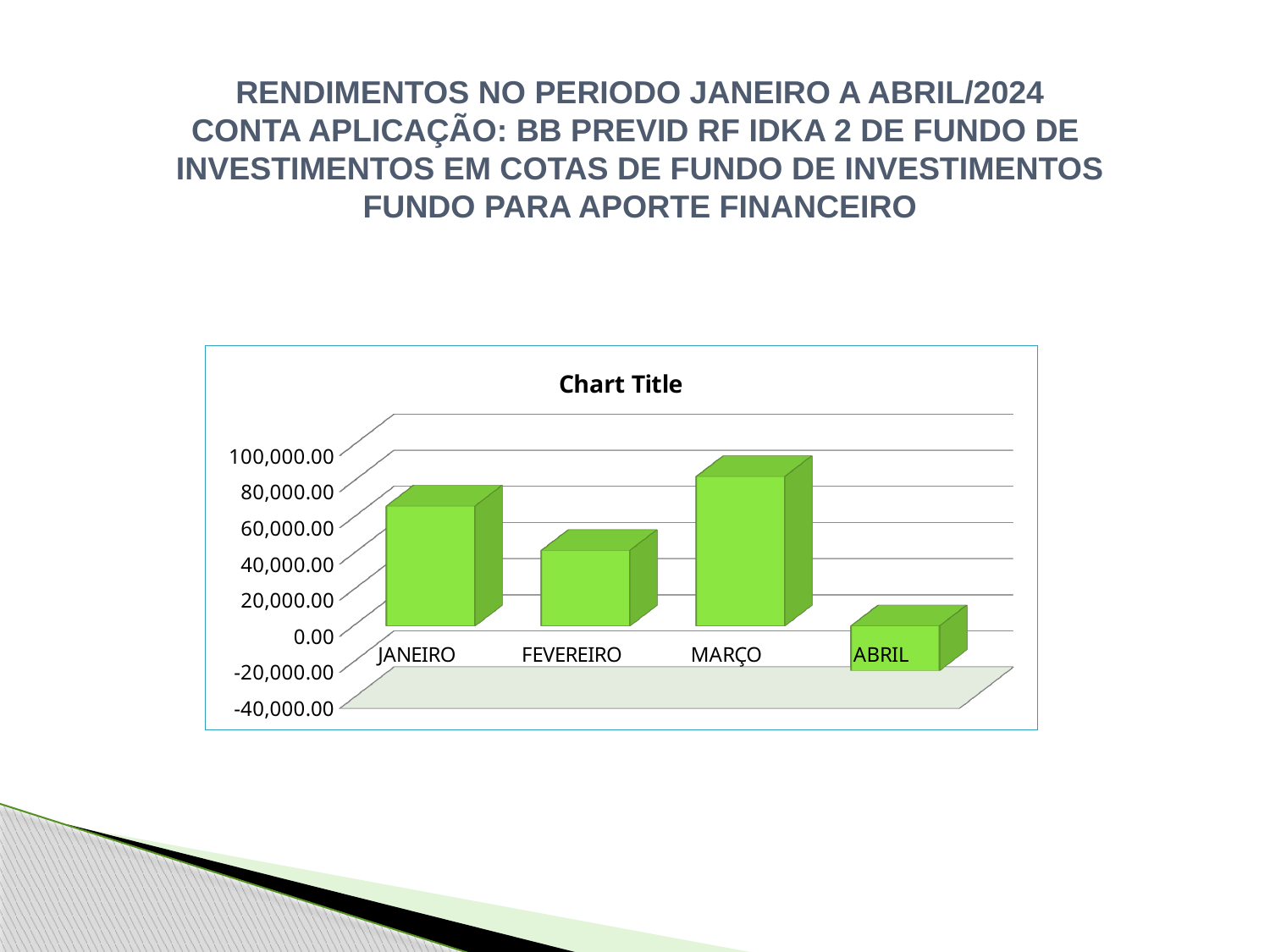
What kind of chart is shown on the slide? bar chart Is the value for ABRIL greater or less than 0.00? less Which is larger, the value for JANEIRO or the value for FEVEREIRO? JANEIRO Is the value for JANEIRO greater or less than 40,000.00? greater What colour are the bars in the chart? green How many months are plotted on the x axis of the chart? 4 Which is larger, the value for MARÇO or the value for FEVEREIRO? MARÇO Which month has the lowest value in the chart? ABRIL Which month has the highest value in the chart? MARÇO Is the value for FEVEREIRO greater or less than 80,000.00? less What title is printed above the plot area of the chart? Chart Title